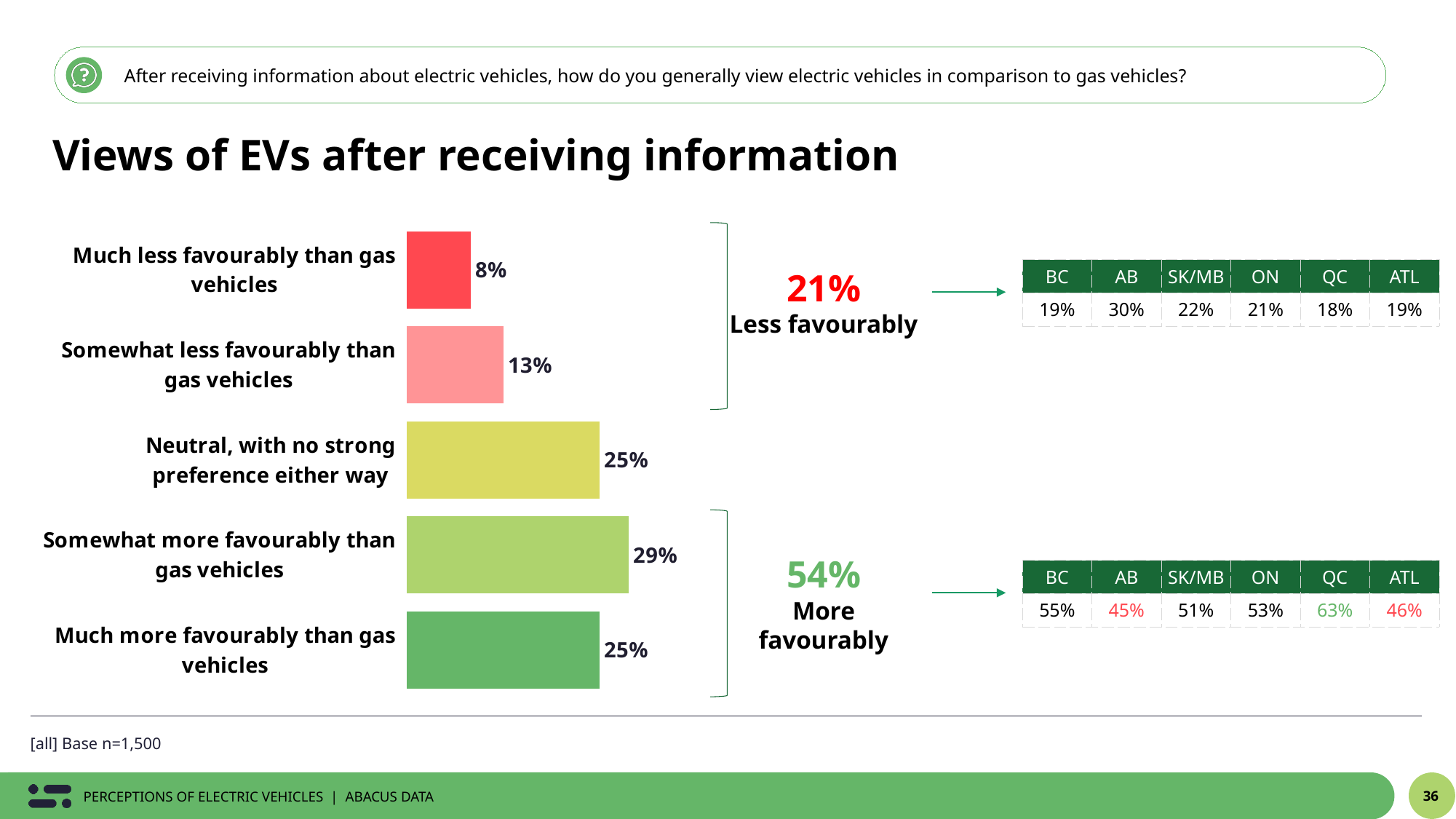
What percentage of respondents view EVs much less favourably than gas vehicles? 8% How many categories are shown in the bar chart? 5 What percentage of respondents are neutral, with no strong preference either way? 25% What is the combined percentage of respondents who view EVs less favourably than gas vehicles? 21% Which category has the highest percentage in the chart? Somewhat more favourably than gas vehicles In the 'Less favourably' regional table, what is the percentage for AB? 30% What kind of chart is shown on the slide? Bar chart In the 'More favourably' regional table, which region has the highest percentage? QC What percentage of respondents view EVs somewhat more favourably than gas vehicles? 29% Which category has the lowest percentage in the chart? Much less favourably than gas vehicles Which is larger: the percentage for 'Somewhat more favourably than gas vehicles' or 'Much more favourably than gas vehicles'? Somewhat more favourably than gas vehicles What is the difference between the percentage for 'Somewhat less favourably than gas vehicles' and 'Much less favourably than gas vehicles'? 5%